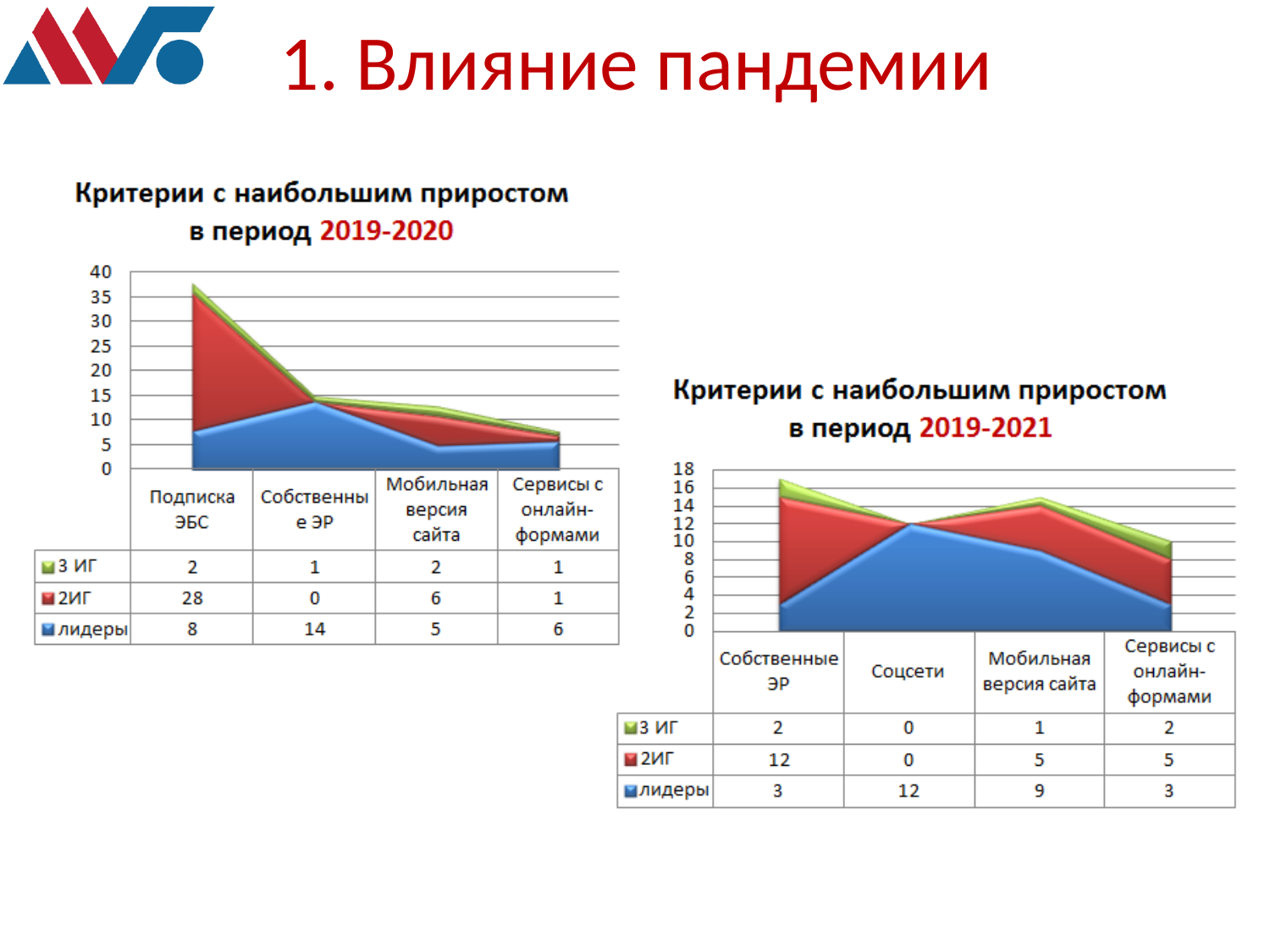
In the chart for 2019-2020, which category has the lowest value for the лидеры series? Мобильная версия сайта In the chart for 2019-2021, which category has the highest value for the 2ИГ series? Собственные ЭР In the chart for 2019-2021, which is larger: the лидеры value for Мобильная версия сайта or for Собственные ЭР? Мобильная версия сайта In the chart for 2019-2020, which category has the highest value for the 2ИГ series? Подписка ЭБС In the chart for 2019-2020, what is the value of the лидеры series for Собственные ЭР? 14 In the chart for 2019-2020, what is the difference between the 2ИГ values for Подписка ЭБС and Мобильная версия сайта? 22 In the chart for 2019-2021, what is the value of the лидеры series for Соцсети? 12 In the chart for 2019-2020, what is the total of all three series for Подписка ЭБС? 38 How many categories are shown on the x axis of the chart for 2019-2020? 4 In the chart for 2019-2020, what is the value of the 2ИГ series for Подписка ЭБС? 28 How many series does the legend list in the chart for 2019-2021? 3 In the chart for 2019-2021, what is the total of all three series for Собственные ЭР? 17